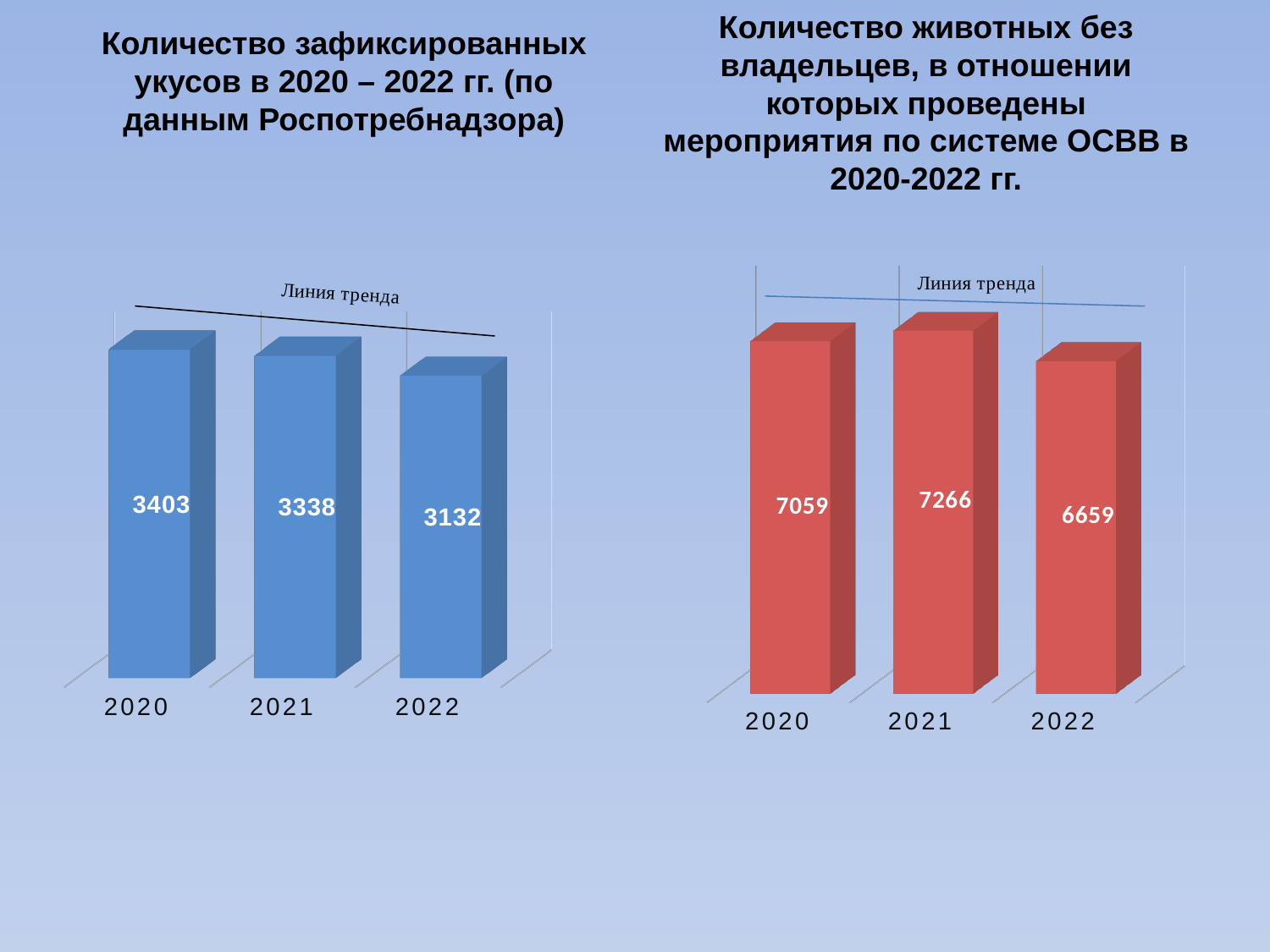
How many years (categories) are shown in the left chart? 3 In the left chart (number of recorded bites), what is the value for 2020? 3403 What type of chart is the right chart? Bar chart In the right chart (animals without owners under the OSVV system), what is the value for 2022? 6659 In the right chart, what is the difference between the values for 2021 and 2022? 607 In the right chart, which year has the lowest value? 2022 In the left chart, what is the difference between the values for 2020 and 2022? 271 In the left chart (number of recorded bites), what is the value for 2022? 3132 In the right chart, which is larger: the value for 2020 or the value for 2021? 2021 In the right chart, which year has the highest value? 2021 In the right chart (animals without owners under the OSVV system), what is the value for 2021? 7266 In the left chart, which year has the highest number of recorded bites? 2020